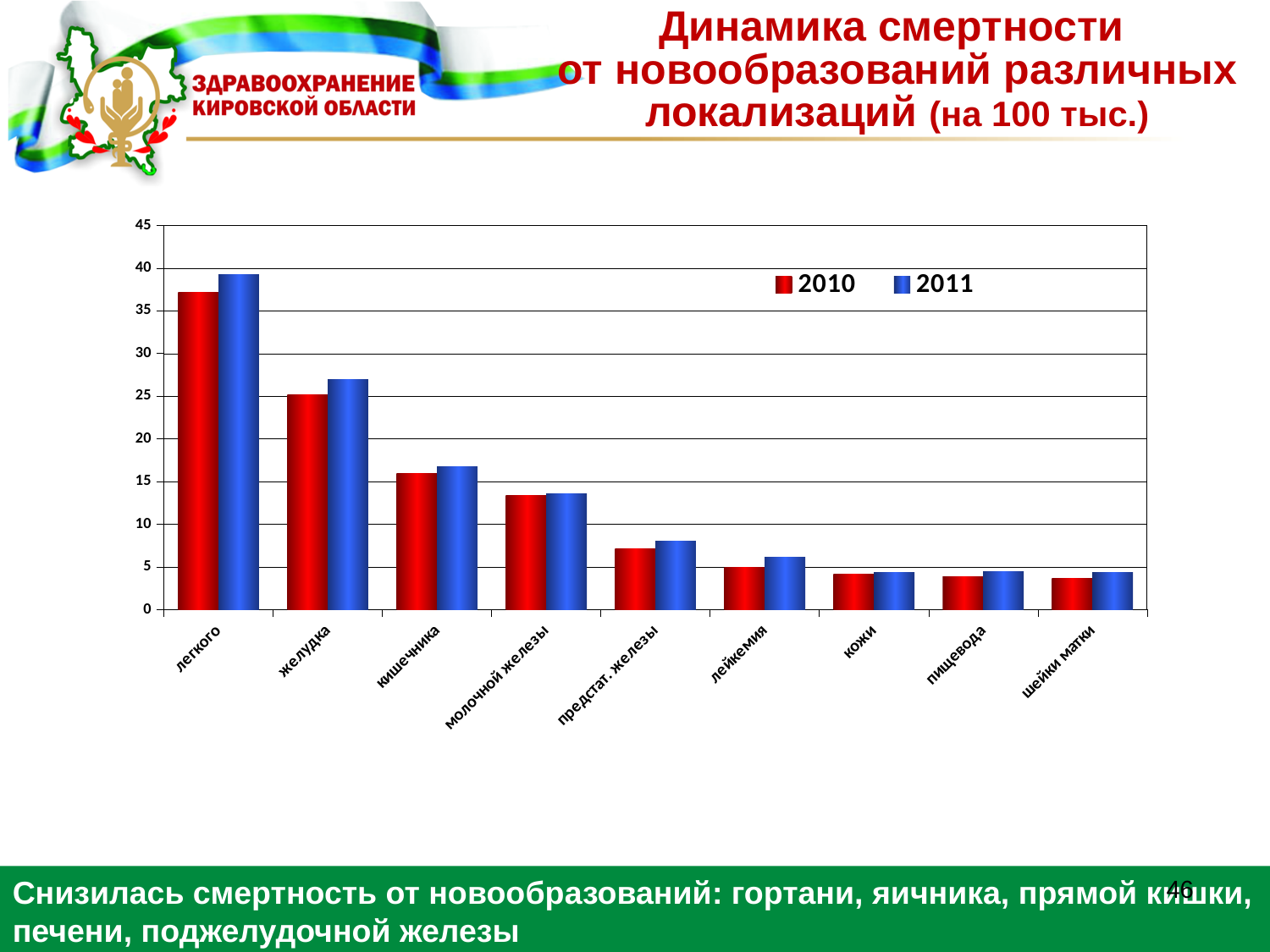
Is the 2011 value for лейкемия greater or less than 5? greater Is the 2010 value for предстат. железы greater or less than 10? less Is the 2010 value for легкого greater or less than 35? greater Which localization has the highest mortality value in 2011? легкого In 2010, which is larger: the value for кишечника or for молочной железы? кишечника How many series does the legend list? 2 Which localization has the highest mortality value in 2010? легкого How many categories (localizations) are shown on the x axis? 9 What kind of chart is shown on the slide? bar chart Do the values generally rise or fall moving from left to right along the x axis? fall For легкого, which year has the larger value, 2010 or 2011? 2011